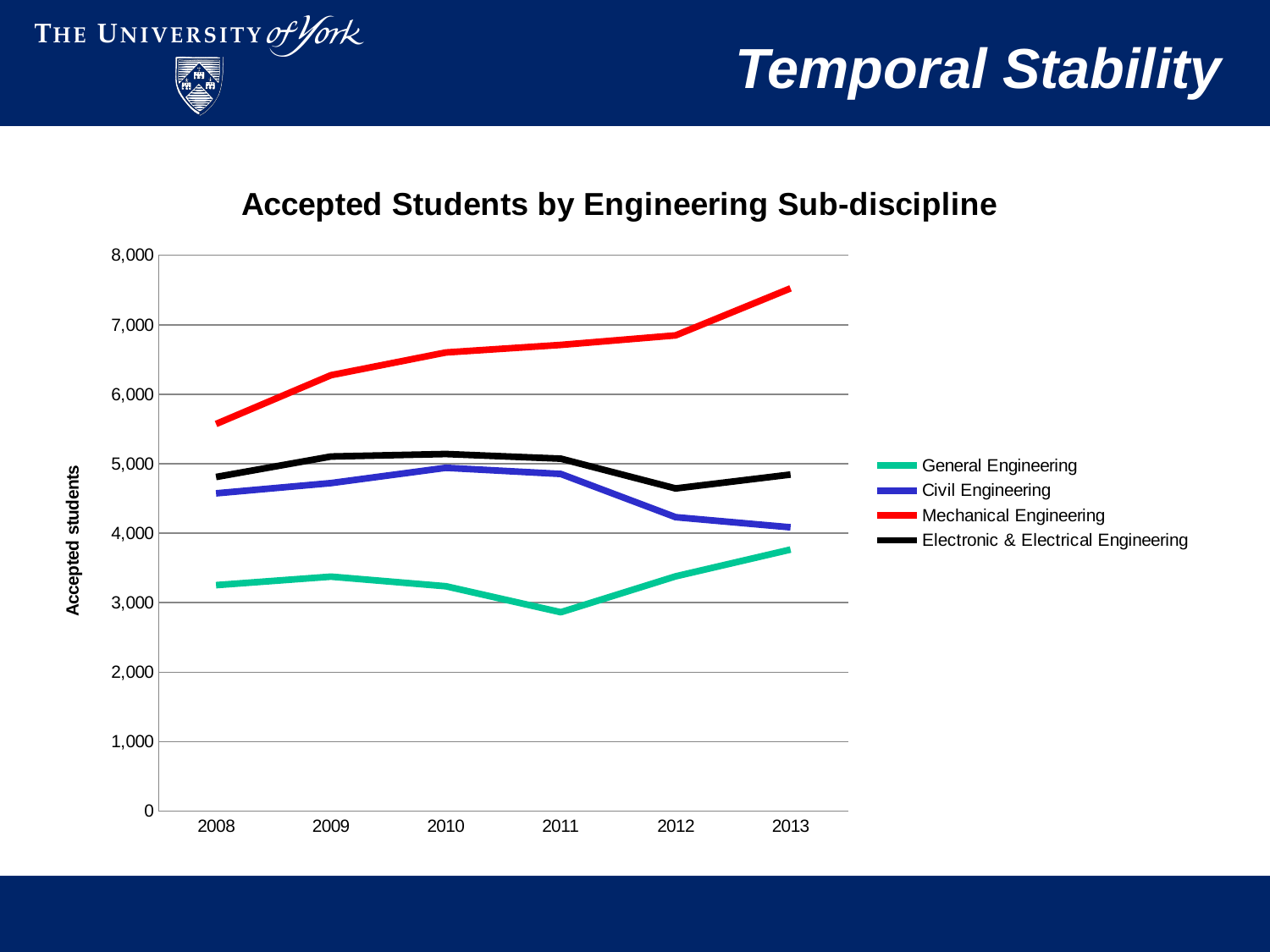
Which sub-discipline has the lowest number of accepted students in 2011? General Engineering Is the value for Mechanical Engineering in 2013 greater or less than 7,000? greater In which year does Mechanical Engineering reach its highest value? 2013 In 2012, which is larger: Electronic & Electrical Engineering or Civil Engineering? Electronic & Electrical Engineering Is the value for General Engineering in 2011 greater or less than 3,000? less How many series does the legend list? 4 Do the values for Mechanical Engineering rise or fall from 2008 to 2013? rise How many years are shown on the x axis? 6 Is the value for Mechanical Engineering in 2008 greater or less than 6,000? less What is the title of the chart? Accepted Students by Engineering Sub-discipline Which sub-discipline has the highest number of accepted students in 2013? Mechanical Engineering What kind of chart is shown on the slide? line chart